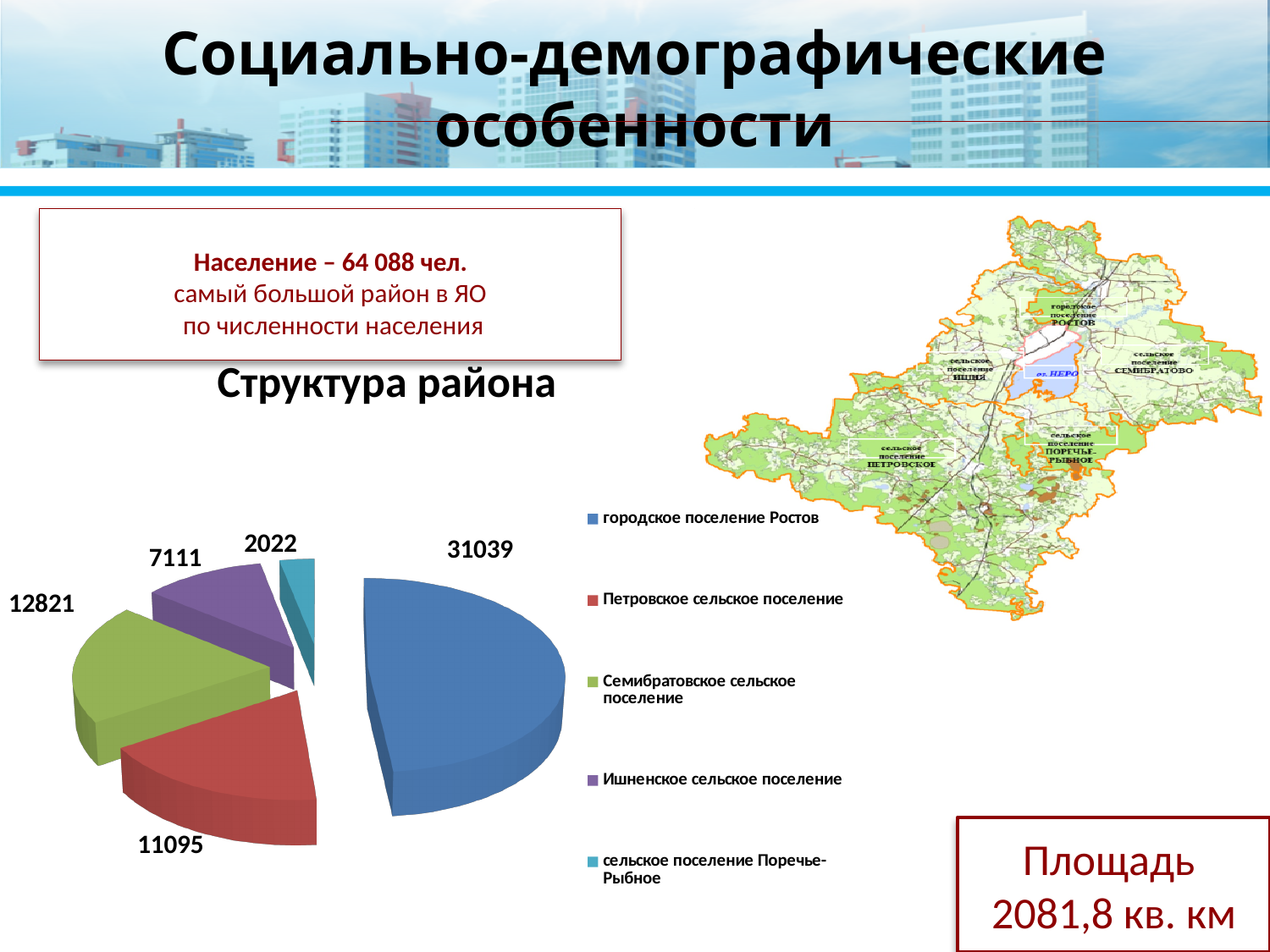
Which category has the smallest slice in the pie chart? сельское поселение Поречье-Рыбное What is the difference between the values for городское поселение Ростов and Петровское сельское поселение? 19944 Which category has the largest slice in the pie chart? городское поселение Ростов What is the value for Петровское сельское поселение in the pie chart? 11095 What colour is the slice for Ишненское сельское поселение in the pie chart? purple What kind of chart is shown under the heading "Структура района"? pie chart How many slices does the pie chart have? 5 What is the value for городское поселение Ростов in the pie chart? 31039 What is the value for Семибратовское сельское поселение in the pie chart? 12821 What is the total of all the slice values in the pie chart? 64088 What is the value for сельское поселение Поречье-Рыбное in the pie chart? 2022 Which is larger in the pie chart: Семибратовское сельское поселение or Ишненское сельское поселение? Семибратовское сельское поселение